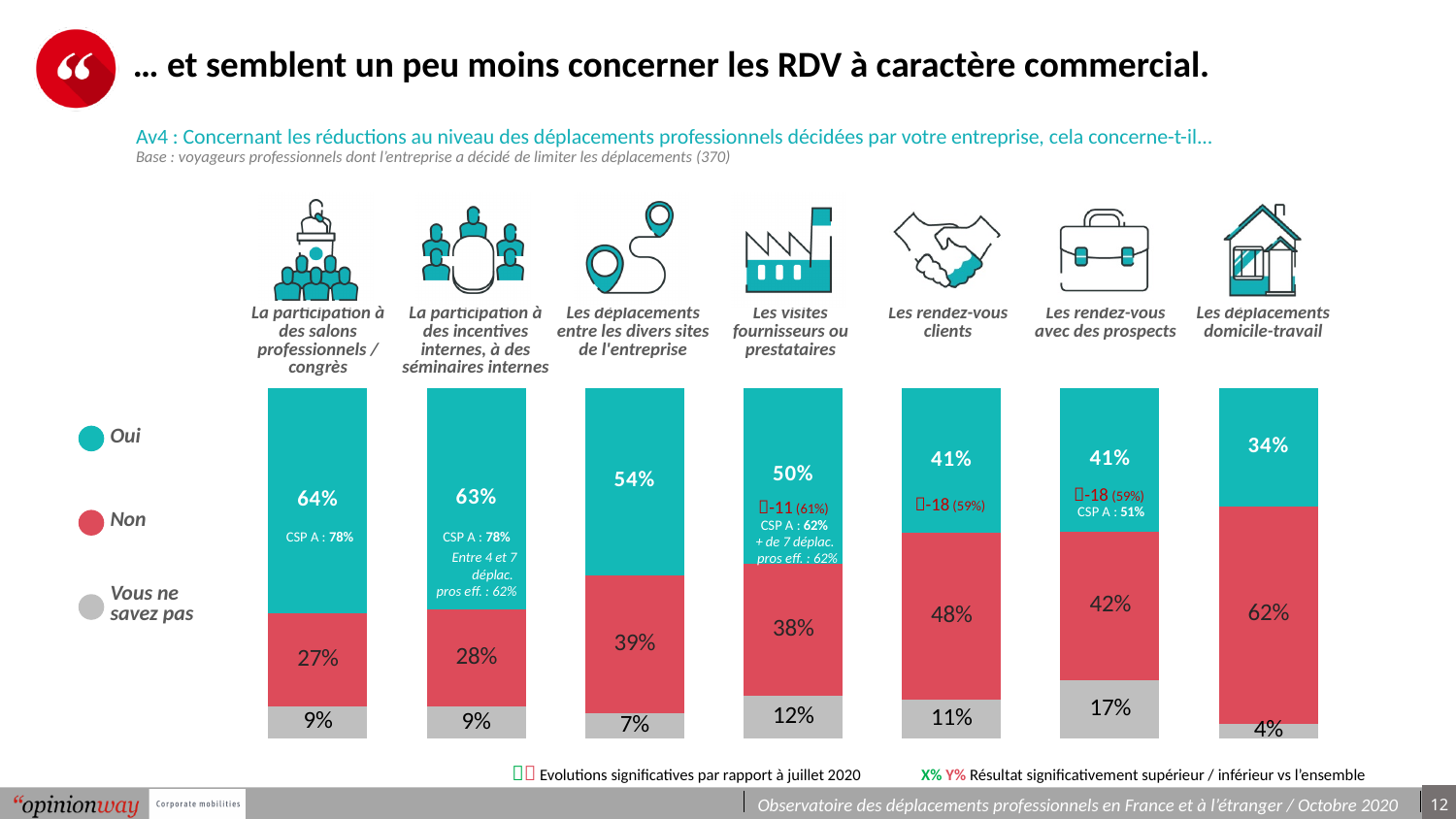
How many series does the legend list? 3 Which category has the highest "Oui" value? La participation à des salons professionnels / congrès Which is larger: the "Oui" value for "Les visites fournisseurs ou prestataires" or the "Oui" value for "Les rendez-vous clients"? Les visites fournisseurs ou prestataires Do the "Oui" values rise or fall from left to right across the categories? Fall What is the difference between the "Non" values for "Les déplacements domicile-travail" and "Les rendez-vous avec des prospects"? 20% What is the "Oui" value for "Les déplacements domicile-travail"? 34% Which category has the lowest "Vous ne savez pas" value? Les déplacements domicile-travail How many categories are shown in the chart? 7 What kind of chart is shown on the slide? Stacked bar chart What is the "Non" value for "Les rendez-vous clients"? 48% Which colour represents the "Non" series in the chart? Red What is the "Vous ne savez pas" value for "Les rendez-vous avec des prospects"? 17%